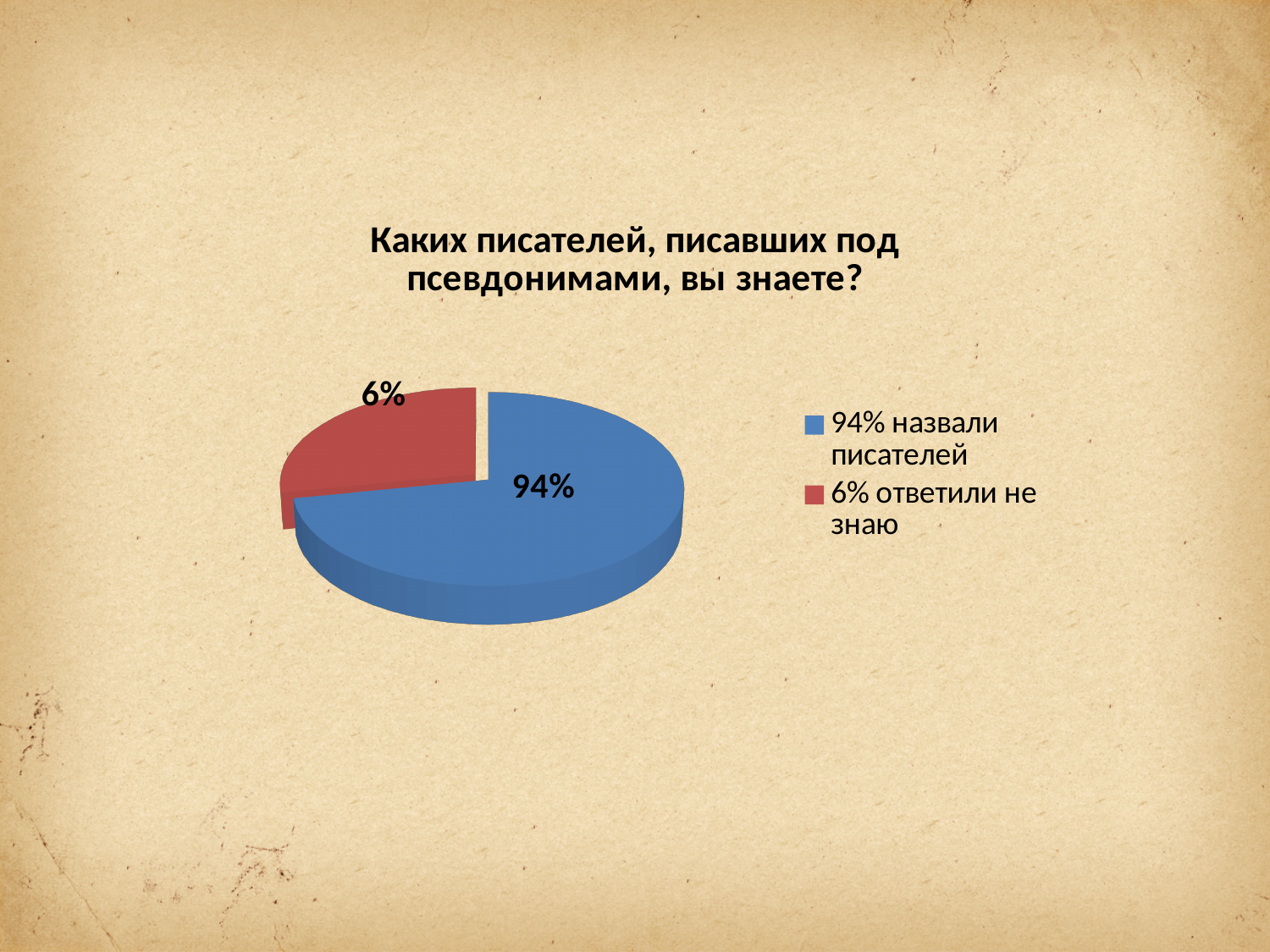
What share of the pie is labelled for the slice '6% ответили не знаю'? 6% What is the difference in percentage points between the two slices? 88 What share of the pie is labelled for the slice '94% назвали писателей'? 94% What colour is the slice for '6% ответили не знаю'? red Which slice is the smallest? 6% ответили не знаю How many slices does the pie chart have? 2 What is the total of the two slice percentages? 100% Which slice is the largest? 94% назвали писателей What kind of chart is shown on the slide? pie chart How many entries does the legend list? 2 What is the title of the chart? Каких писателей, писавших под псевдонимами, вы знаете? Which is larger: the slice for 'назвали писателей' or the slice for 'ответили не знаю'? назвали писателей